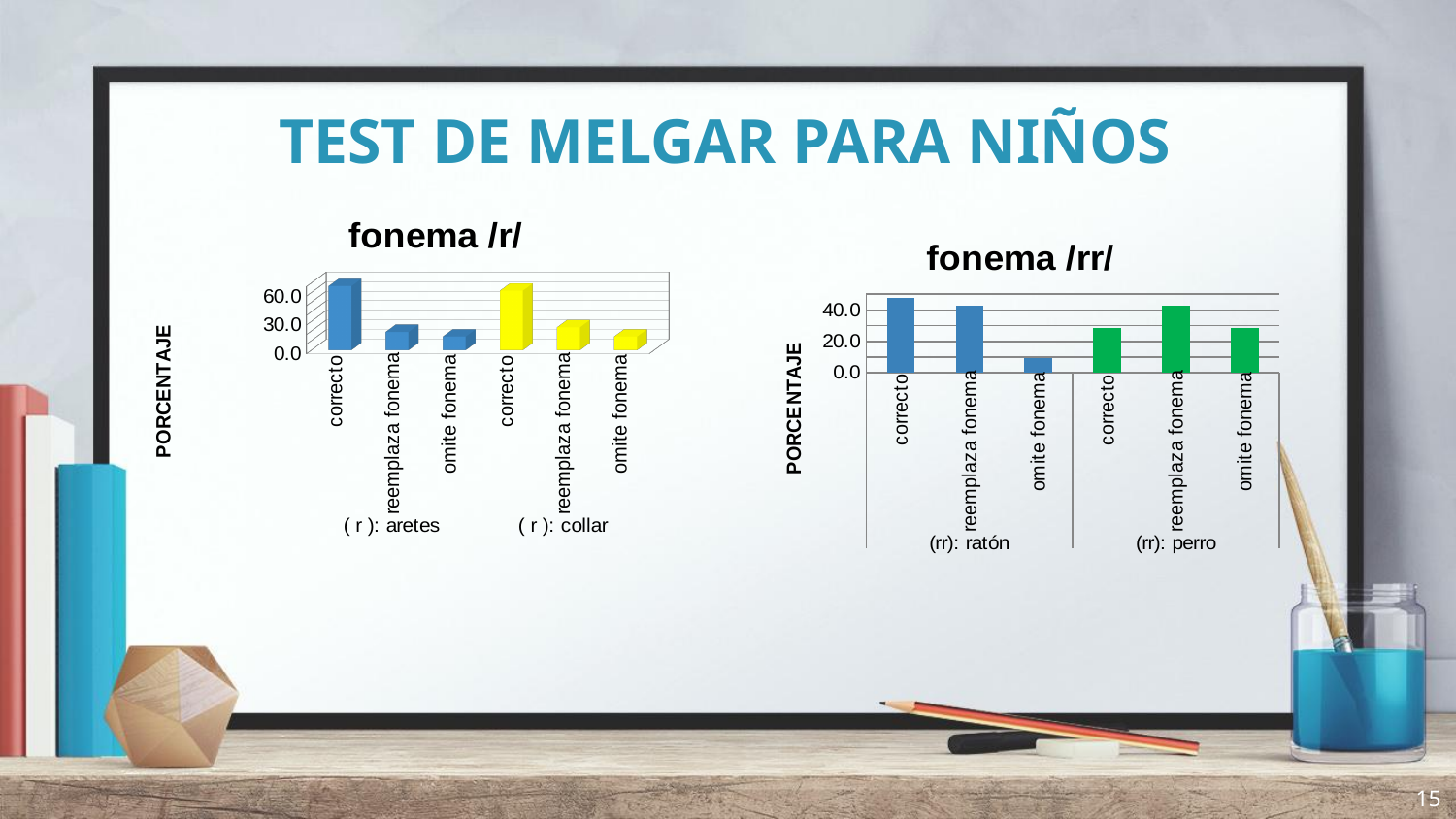
In the 'fonema /r/' chart, is the value for 'omite fonema' under '( r ): collar' greater or less than 30.0? less What kind of chart is the 'fonema /r/' chart? bar chart What is the label on the vertical axis of the 'fonema /rr/' chart? PORCENTAJE In the 'fonema /r/' chart, which is larger: 'correcto' under '( r ): aretes' or 'reemplaza fonema' under '( r ): aretes'? correcto under ( r ): aretes In the 'fonema /rr/' chart, is the value for 'omite fonema' under '(rr): ratón' greater or less than 20.0? less What kind of chart is the 'fonema /rr/' chart? bar chart In the 'fonema /rr/' chart, which is larger: 'correcto' under '(rr): ratón' or 'correcto' under '(rr): perro'? correcto under (rr): ratón In the 'fonema /r/' chart, is the value for 'correcto' under '( r ): aretes' greater or less than 30.0? greater How many bars are plotted in the 'fonema /r/' chart? 6 In the 'fonema /rr/' chart, which bar is the lowest? omite fonema under (rr): ratón How many bars are plotted in the 'fonema /rr/' chart? 6